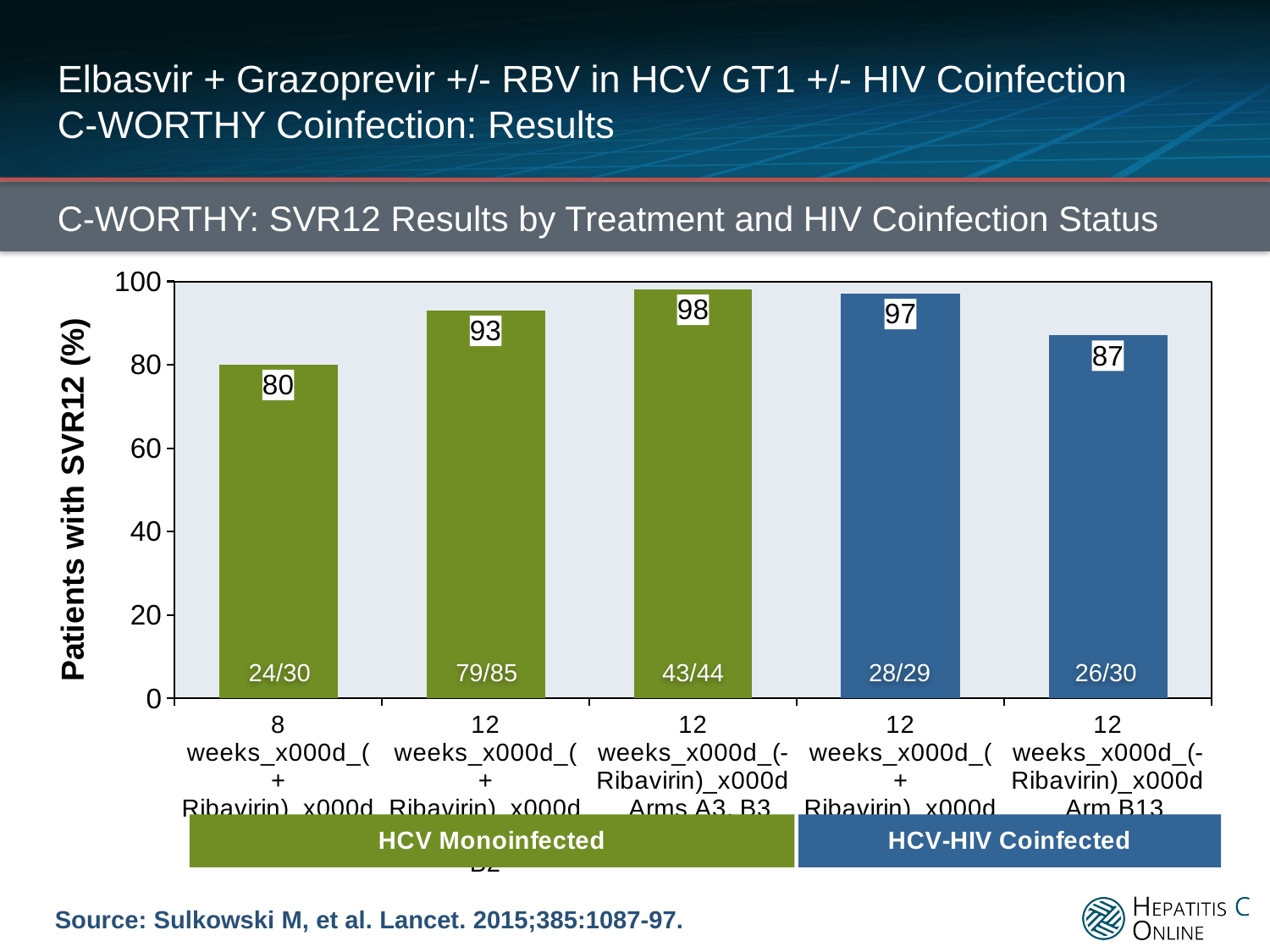
Which bar has the lowest SVR12 percentage? 8 weeks (+ Ribavirin), HCV Monoinfected What is the SVR12 percentage for the 8-week (+ Ribavirin) HCV monoinfected arm? 80 What is the SVR12 percentage for the 12-week (- Ribavirin) HCV-HIV coinfected arm (Arm B13)? 87 What is the difference in SVR12 percentage between the 12-week (+ Ribavirin) HCV monoinfected arm and the 8-week (+ Ribavirin) HCV monoinfected arm? 13 How many bars are plotted in the chart? 5 Which is larger: the SVR12 percentage for the 12-week (+ Ribavirin) HCV-HIV coinfected arm or the 12-week (- Ribavirin) HCV-HIV coinfected arm? 12 weeks (+ Ribavirin), 97 What fraction of patients is shown inside the bar for the 12-week (- Ribavirin) HCV monoinfected arm (Arms A3, B3)? 43/44 What is the SVR12 percentage for the 12-week (+ Ribavirin) HCV-HIV coinfected arm? 97 Which colour represents the HCV-HIV Coinfected group? blue Which bar has the highest SVR12 percentage? 12 weeks (- Ribavirin), Arms A3, B3 (HCV Monoinfected) What type of chart is shown on the slide? bar chart What is the label of the y-axis? Patients with SVR12 (%)